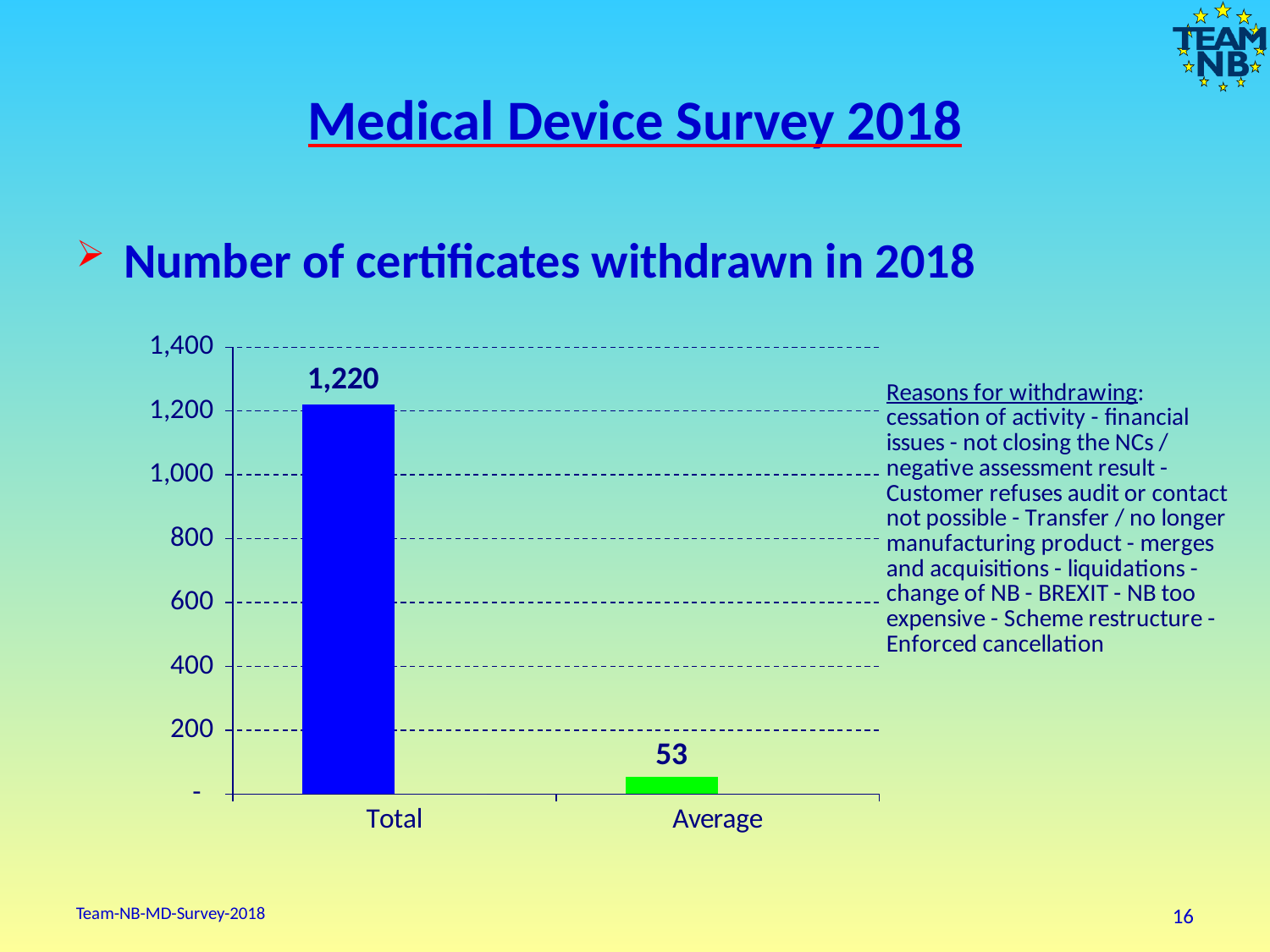
What is the difference between the Total and Average values? 1,167 What kind of chart is shown on the slide? bar chart What is the maximum value shown on the y axis? 1,400 How many categories are shown on the x axis? 2 Which category has the highest value? Total What colour is the Average bar? green Which category has the lowest value? Average What is the value of the Average bar? 53 Which is larger, the Total value or the Average value? Total Is the value for Total greater or less than 1,000? greater What is the value of the Total bar? 1,220 Is the value for Average greater or less than 200? less